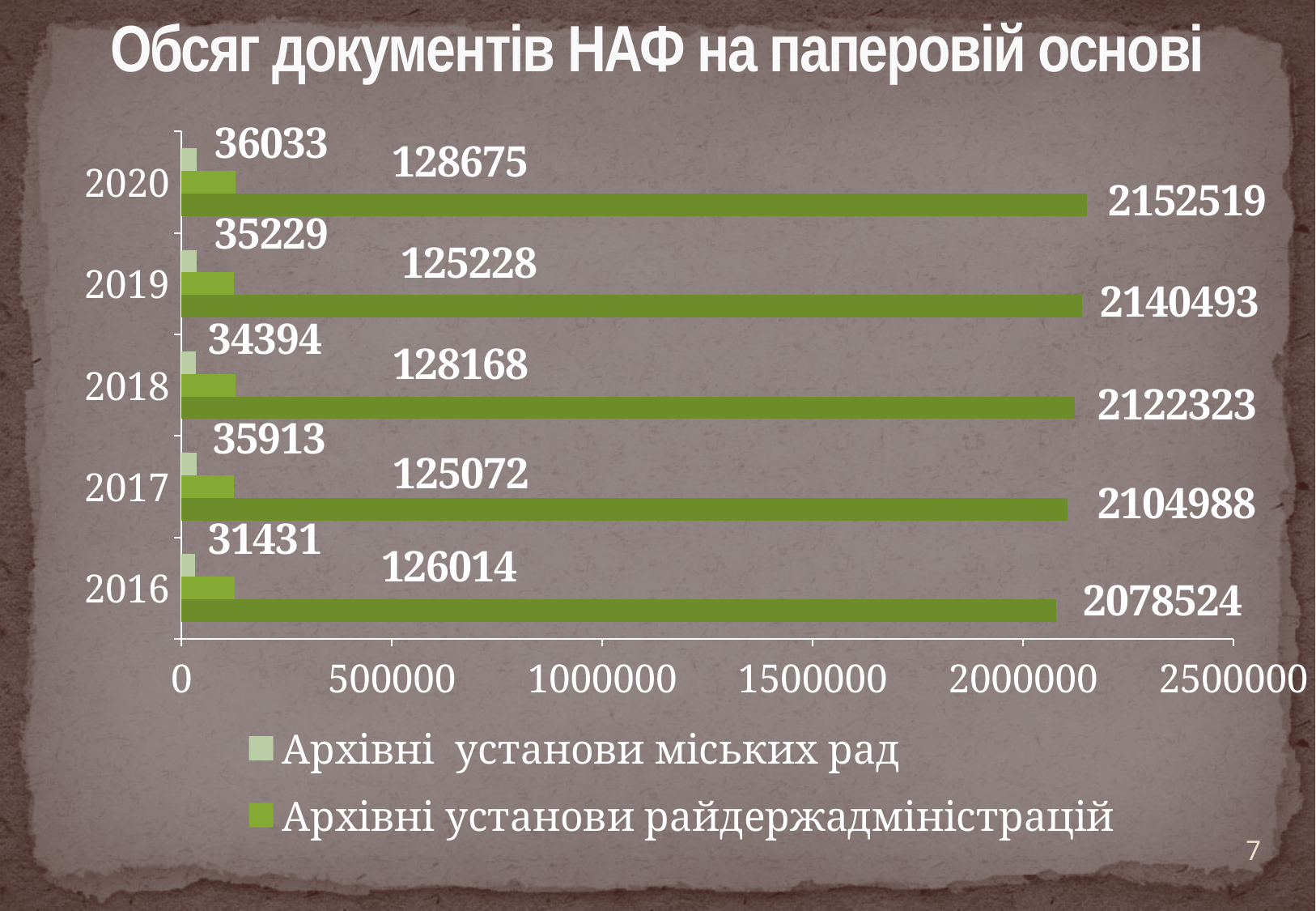
What kind of chart is shown on the slide? bar chart How many years are shown on the vertical axis of the chart? 5 What is the title of the chart? Обсяг документів НАФ на паперовій основі How many series does the legend list? 2 Which is larger for Архівні установи райдержадміністрацій: the 2019 value or the 2017 value? 2019 In which year is the value for Архівні установи міських рад the lowest? 2016 What is the value for Архівні установи міських рад in 2017? 35913 In which year is the value for Архівні установи райдержадміністрацій the highest? 2020 What is the difference between the 2020 and 2016 values for Архівні установи міських рад? 4602 What is the value for Архівні установи райдержадміністрацій in 2018? 128168 What is the value for Архівні установи міських рад in 2020? 36033 In which year is the value for Архівні установи міських рад the highest? 2020